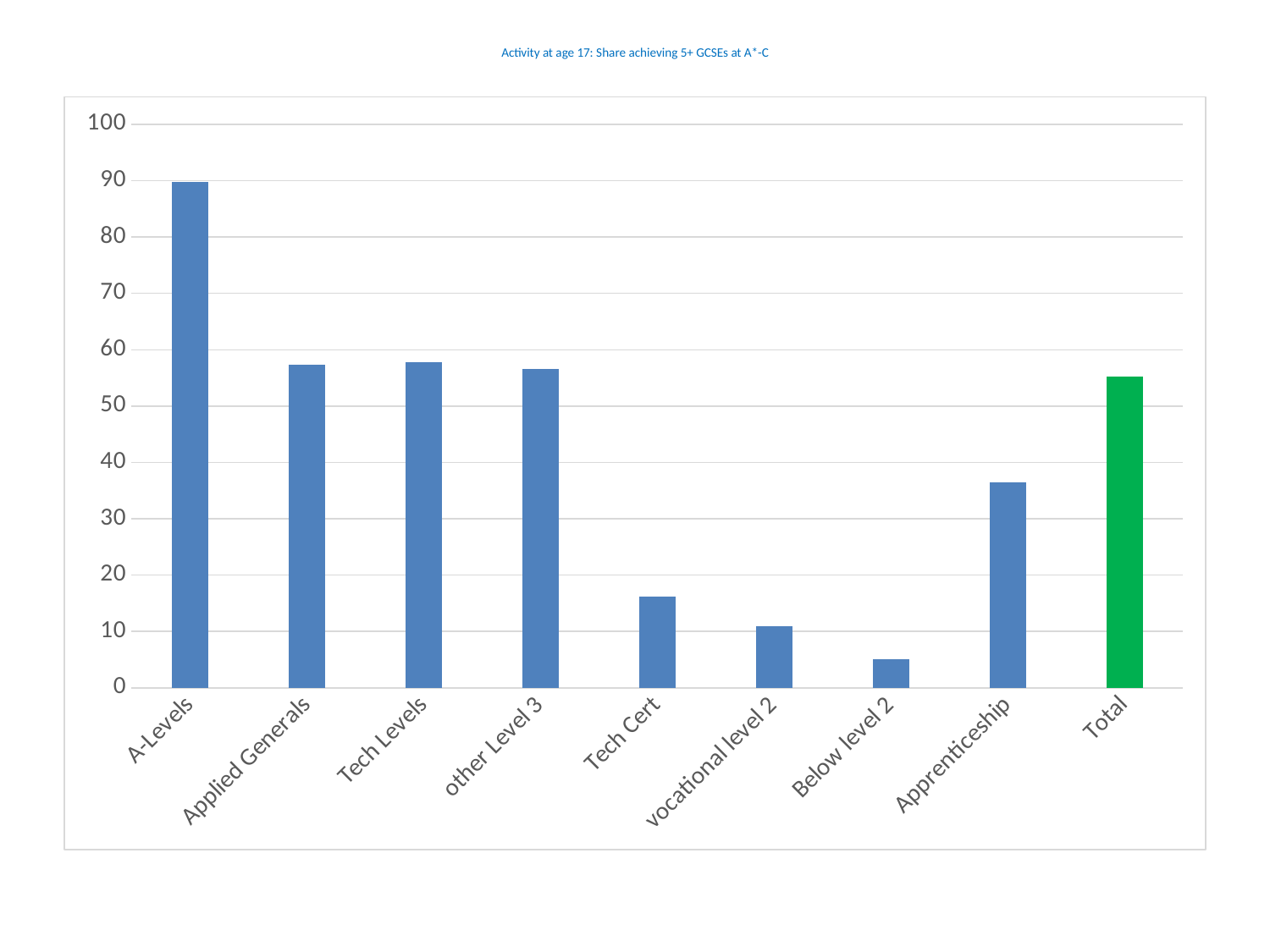
How many categories are shown on the x axis? 9 Is the value for Tech Cert greater or less than 20? less Is the value for Below level 2 greater or less than 10? less Is the value for A-Levels greater or less than 80? greater Which category has the lowest value? Below level 2 Which category has the highest value? A-Levels What is the title of the chart? Activity at age 17: Share achieving 5+ GCSEs at A*-C Which is larger, the value for vocational level 2 or the value for Total? Total What kind of chart is shown on the slide? bar chart Which bar is coloured differently from the others? Total Which is larger, the value for Apprenticeship or the value for Tech Cert? Apprenticeship